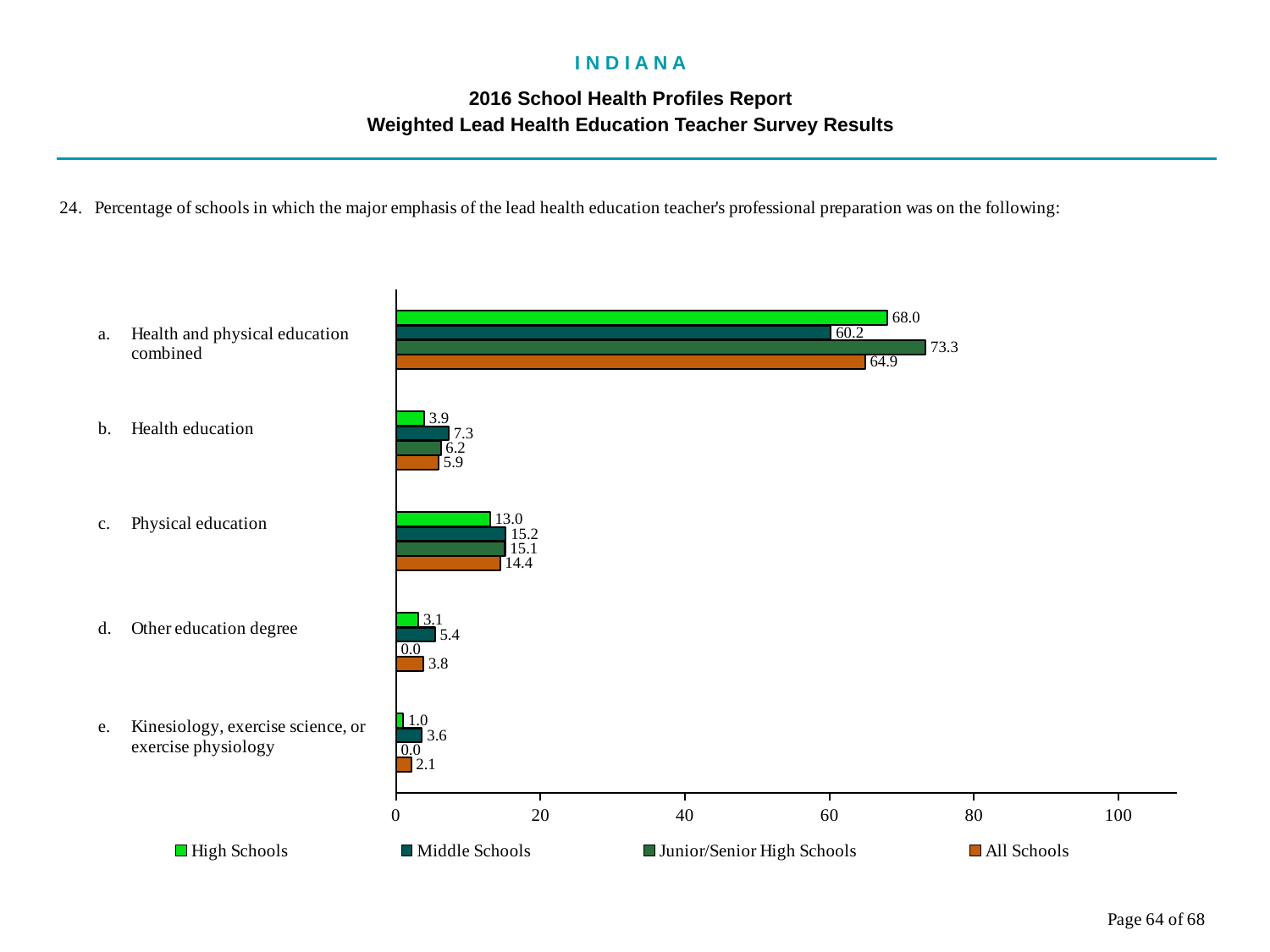
What is the value for All Schools for 'Kinesiology, exercise science, or exercise physiology'? 2.1 How many series does the legend list? 4 Which is larger for 'Health education': the High Schools value or the Middle Schools value? Middle Schools What is the difference between the Junior/Senior High Schools and Middle Schools values for 'Health and physical education combined'? 13.1 Which category has the lowest value for High Schools? Kinesiology, exercise science, or exercise physiology What is the value for Middle Schools for 'Other education degree'? 5.4 What kind of chart is shown on the slide? bar chart How many categories are shown on the chart? 5 Is the All Schools value for 'Health and physical education combined' greater or less than 60? greater What is the value for High Schools for 'Health and physical education combined'? 68.0 Which series has the highest value for 'Health and physical education combined'? Junior/Senior High Schools What is the value for Junior/Senior High Schools for 'Physical education'? 15.1